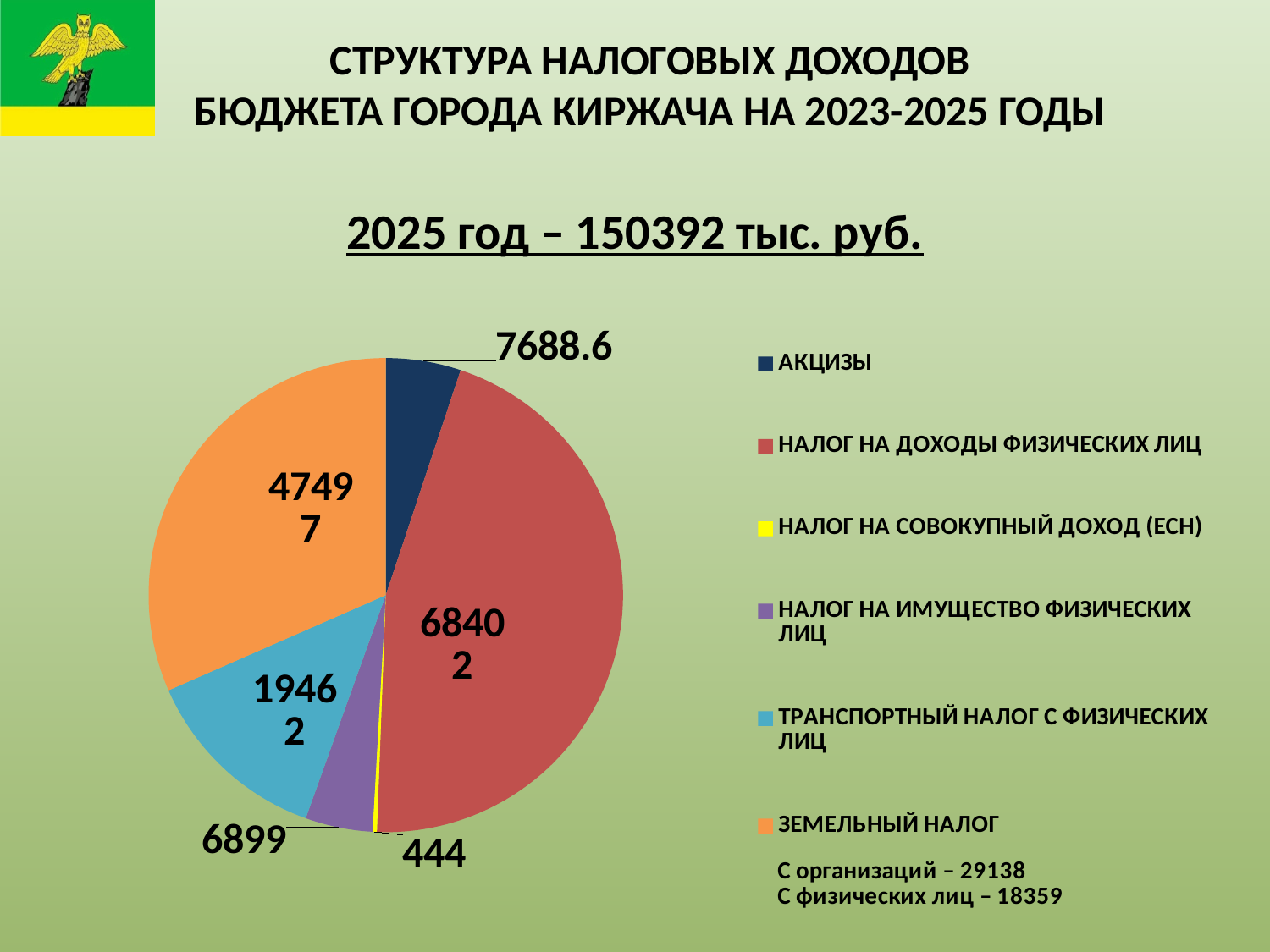
What value is shown for НАЛОГ НА СОВОКУПНЫЙ ДОХОД (ЕСН) in the pie chart? 444 Which is larger: ТРАНСПОРТНЫЙ НАЛОГ С ФИЗИЧЕСКИХ ЛИЦ or НАЛОГ НА ИМУЩЕСТВО ФИЗИЧЕСКИХ ЛИЦ? ТРАНСПОРТНЫЙ НАЛОГ С ФИЗИЧЕСКИХ ЛИЦ Which category has the smallest slice of the pie chart? НАЛОГ НА СОВОКУПНЫЙ ДОХОД (ЕСН) What kind of chart is shown on the slide? Pie chart What is the difference between the values for НАЛОГ НА ДОХОДЫ ФИЗИЧЕСКИХ ЛИЦ and ЗЕМЕЛЬНЫЙ НАЛОГ? 20905 Which category has the largest slice of the pie chart? НАЛОГ НА ДОХОДЫ ФИЗИЧЕСКИХ ЛИЦ What value is shown for ЗЕМЕЛЬНЫЙ НАЛОГ in the pie chart? 47497 What colour is the slice for ЗЕМЕЛЬНЫЙ НАЛОГ? Orange What value is shown for ТРАНСПОРТНЫЙ НАЛОГ С ФИЗИЧЕСКИХ ЛИЦ in the pie chart? 19462 What value is shown for АКЦИЗЫ in the pie chart? 7688.6 How many slices does the pie chart have? 6 What value is shown for НАЛОГ НА ДОХОДЫ ФИЗИЧЕСКИХ ЛИЦ in the pie chart? 68402